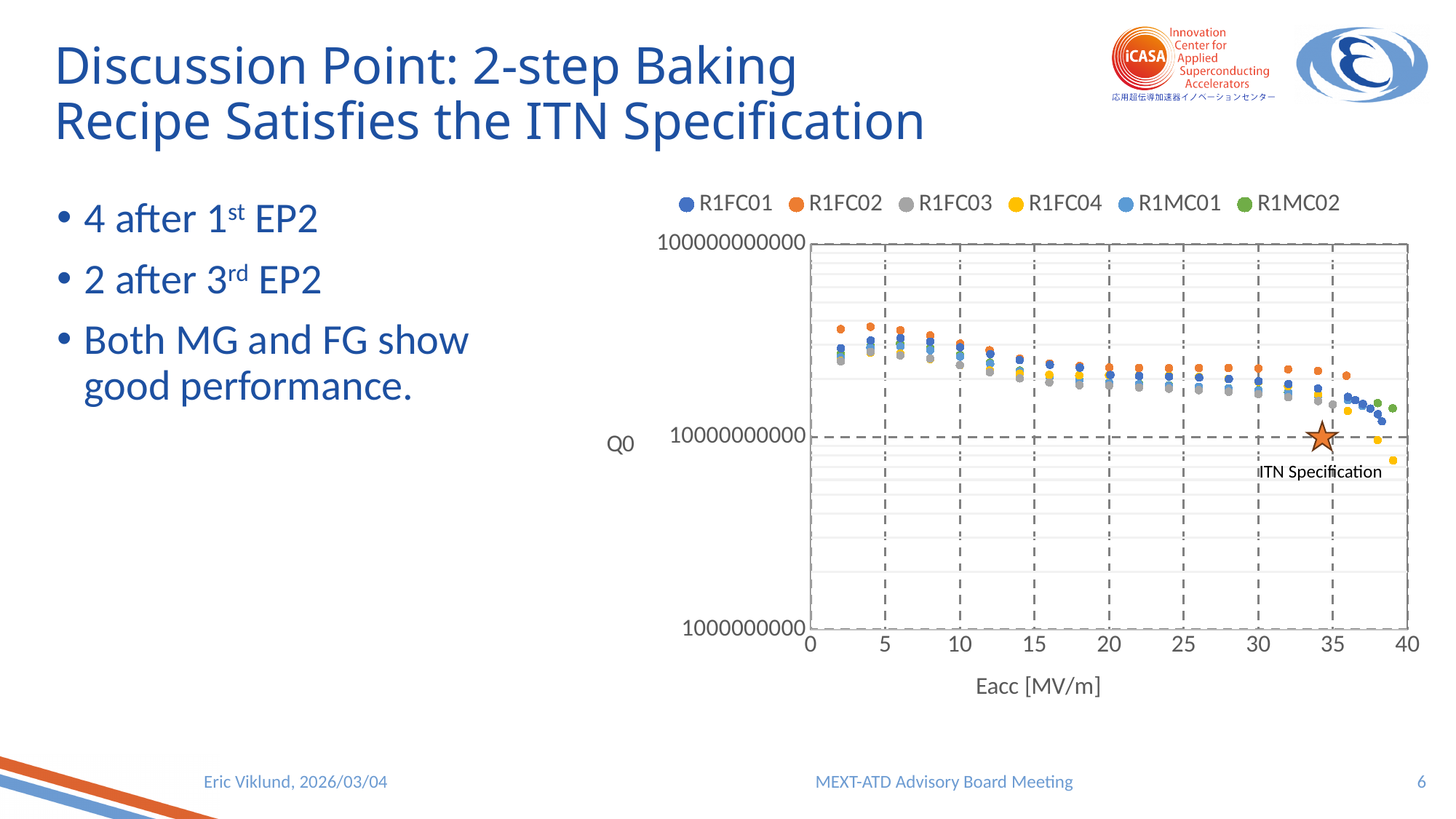
Is the Q0 value for R1FC04 at Eacc = 39 MV/m greater or less than 10000000000? less Is the Q0 value for R1FC02 at Eacc = 36 MV/m greater or less than 10000000000? greater Is the Q0 value for R1FC02 at Eacc = 2 MV/m greater or less than 10000000000? greater Which series are listed in the chart legend? R1FC01, R1FC02, R1FC03, R1FC04, R1MC01, R1MC02 Which series has the lowest Q0 at the highest Eacc values shown (around 38-39 MV/m)? R1FC04 At Eacc = 2 MV/m, which series has a higher Q0, R1FC02 or R1FC03? R1FC02 What kind of chart is shown on the slide? scatter chart How many series does the chart legend list? 6 What is the label of the x axis of the chart? Eacc [MV/m] As Eacc increases along the x axis, do the Q0 values generally rise or fall? fall At Eacc = 4 MV/m, which series has the highest Q0? R1FC02 At Eacc = 30 MV/m, which series has a higher Q0, R1FC02 or R1FC04? R1FC02